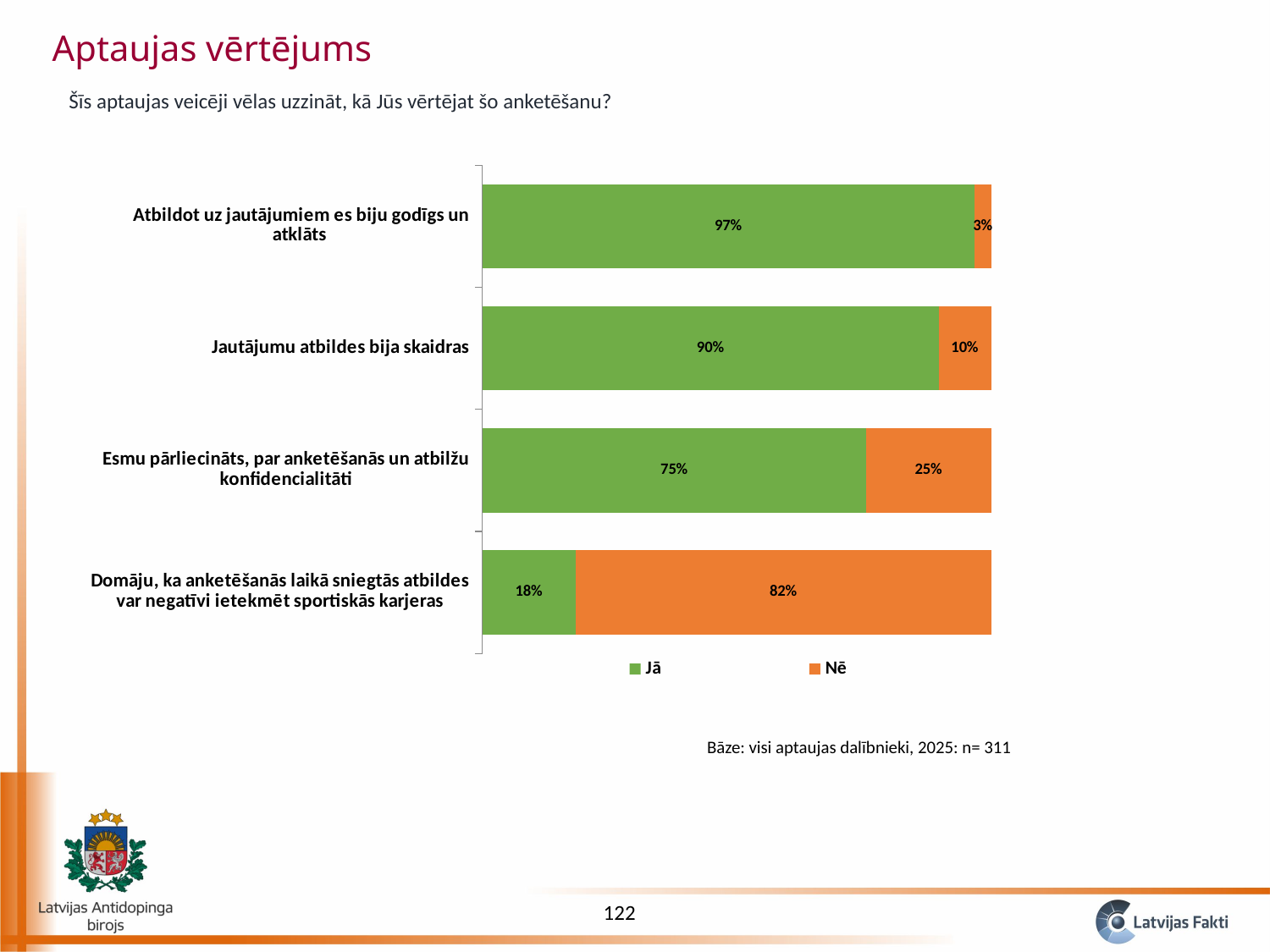
Which category has the lowest "Jā" value? Domāju, ka anketēšanās laikā sniegtās atbildes var negatīvi ietekmēt sportiskās karjeras What is the difference between the "Jā" values for "Jautājumu atbildes bija skaidras" and "Esmu pārliecināts, par anketēšanās un atbilžu konfidencialitāti"? 15% How many categories are shown in the chart? 4 How many series does the legend list? 2 What kind of chart is shown on the slide? Stacked bar chart What is the "Jā" value for "Domāju, ka anketēšanās laikā sniegtās atbildes var negatīvi ietekmēt sportiskās karjeras"? 18% What is the "Nē" value for "Esmu pārliecināts, par anketēšanās un atbilžu konfidencialitāti"? 25% Which category has the highest "Jā" value? Atbildot uz jautājumiem es biju godīgs un atklāts Which is larger: the "Nē" value for "Jautājumu atbildes bija skaidras" or the "Nē" value for "Esmu pārliecināts, par anketēšanās un atbilžu konfidencialitāti"? Esmu pārliecināts, par anketēšanās un atbilžu konfidencialitāti What is the "Nē" value for "Atbildot uz jautājumiem es biju godīgs un atklāts"? 3% What is the total of the stacked bar for "Domāju, ka anketēšanās laikā sniegtās atbildes var negatīvi ietekmēt sportiskās karjeras"? 100% What is the "Jā" value for "Jautājumu atbildes bija skaidras"? 90%